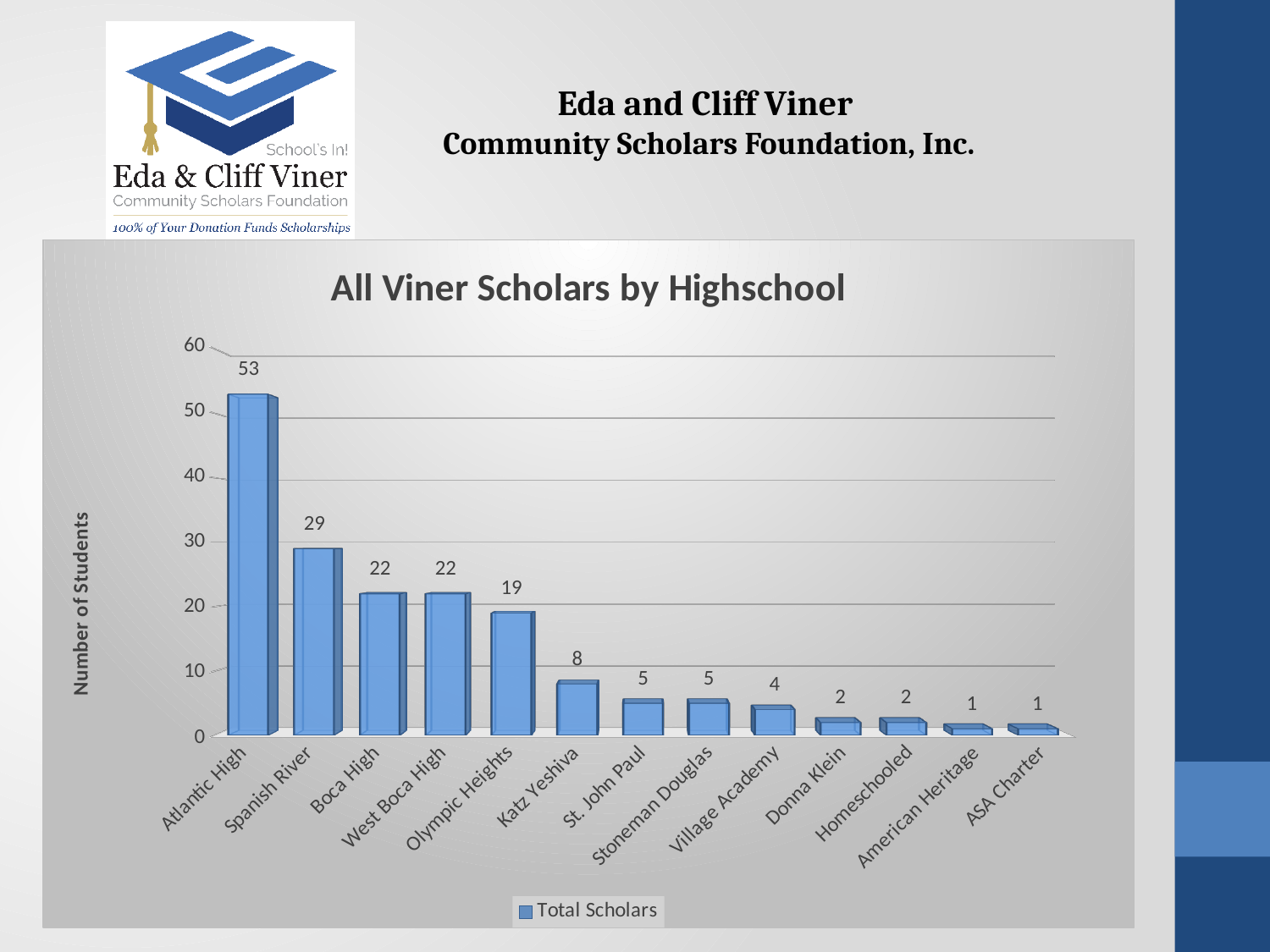
How many Viner scholars came from Atlantic High? 53 How many scholars are shown for Katz Yeshiva? 8 What is the difference in number of students between Atlantic High and Spanish River? 24 What kind of chart is shown on the slide? Bar chart How many series does the legend list? 1 What is the number of students shown for Olympic Heights? 19 Do the values rise or fall moving from left to right along the x axis? Fall What is the title of the chart? All Viner Scholars by Highschool Which high school has the highest number of Viner scholars? Atlantic High Is the value for Spanish River greater or less than 20? greater Which has more scholars, Olympic Heights or Katz Yeshiva? Olympic Heights How many high school categories are shown on the x axis? 13